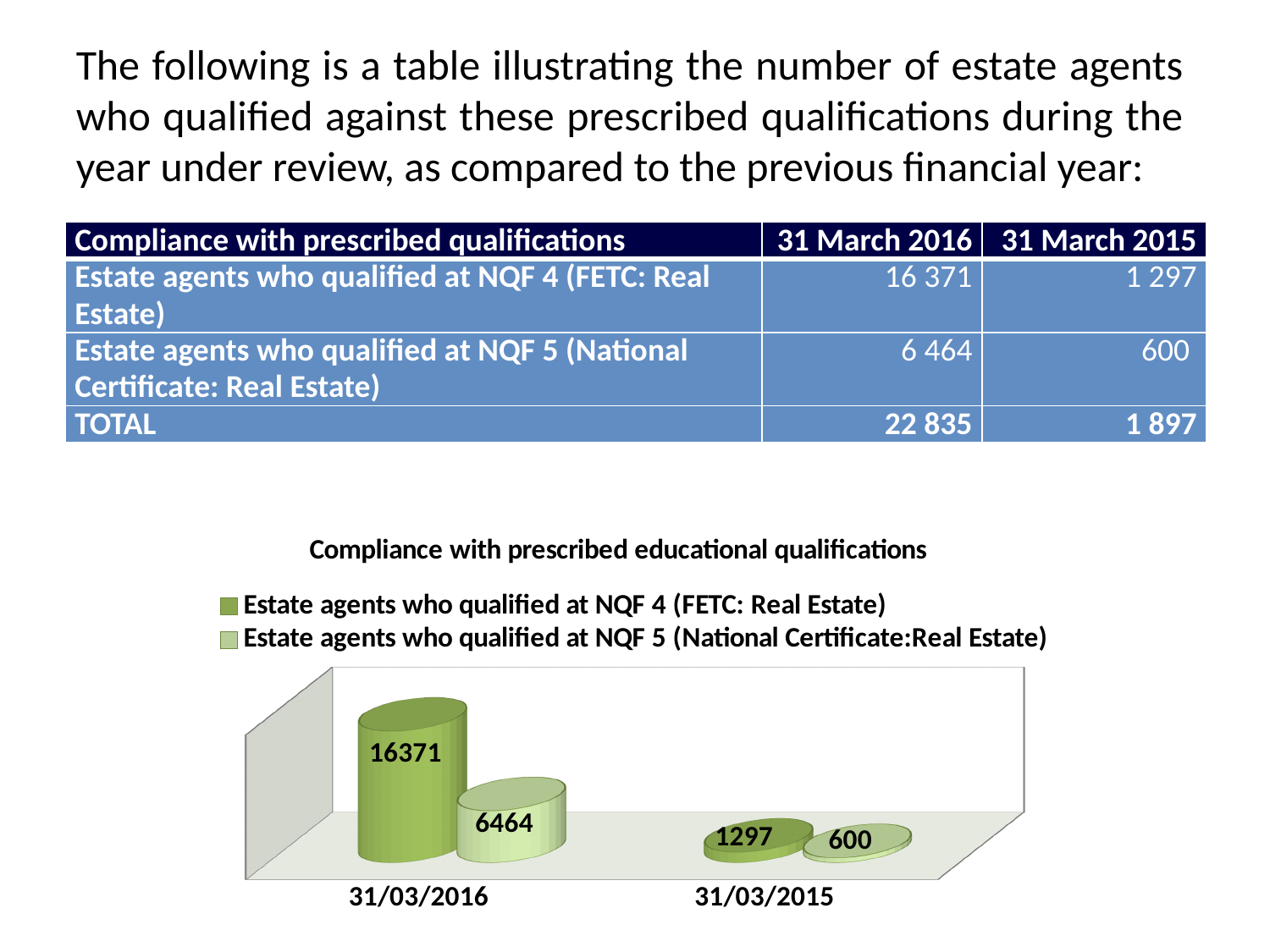
How many categories are shown on the x axis of the chart? 2 Which bar in the chart has the highest value? NQF 4 (FETC: Real Estate) on 31/03/2016 What is the value for estate agents who qualified at NQF 4 (FETC: Real Estate) on 31/03/2016? 16371 What is the difference between the NQF 4 value on 31/03/2016 and the NQF 4 value on 31/03/2015? 15074 Which is larger: the NQF 5 value on 31/03/2016 or the NQF 4 value on 31/03/2015? NQF 5 value on 31/03/2016 Which bar in the chart has the lowest value? NQF 5 (National Certificate: Real Estate) on 31/03/2015 What is the value for estate agents who qualified at NQF 5 (National Certificate: Real Estate) on 31/03/2016? 6464 What is the difference between the NQF 4 and NQF 5 values on 31/03/2016? 9907 What is the value for estate agents who qualified at NQF 4 (FETC: Real Estate) on 31/03/2015? 1297 What is the title of the chart? Compliance with prescribed educational qualifications How many series does the chart legend list? 2 What is the value for estate agents who qualified at NQF 5 (National Certificate: Real Estate) on 31/03/2015? 600